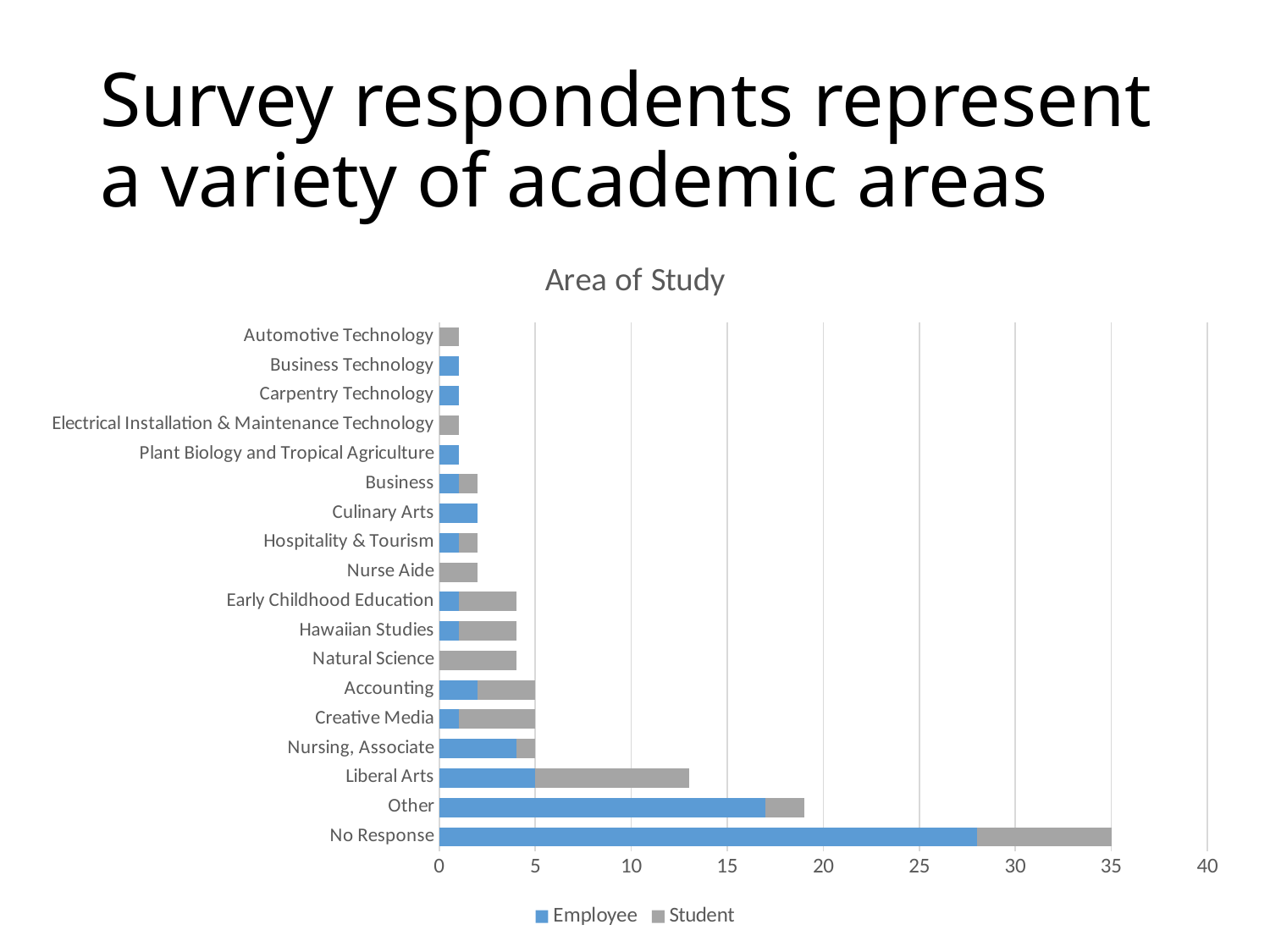
Which area of study has the highest total number of respondents? No Response What is the title of the chart? Area of Study Which series is shown in blue in the legend? Employee Is the Employee value for No Response greater or less than 25? greater How many series does the legend list? 2 Is the total value for Liberal Arts greater or less than 10? greater What kind of chart is shown on the slide? bar chart What is the total number of respondents for No Response? 35 Which has more total respondents, Liberal Arts or Other? Other What is the total number of respondents for Accounting? 5 Is the total value for Other greater or less than 15? greater How many categories (areas of study) are shown on the chart? 18